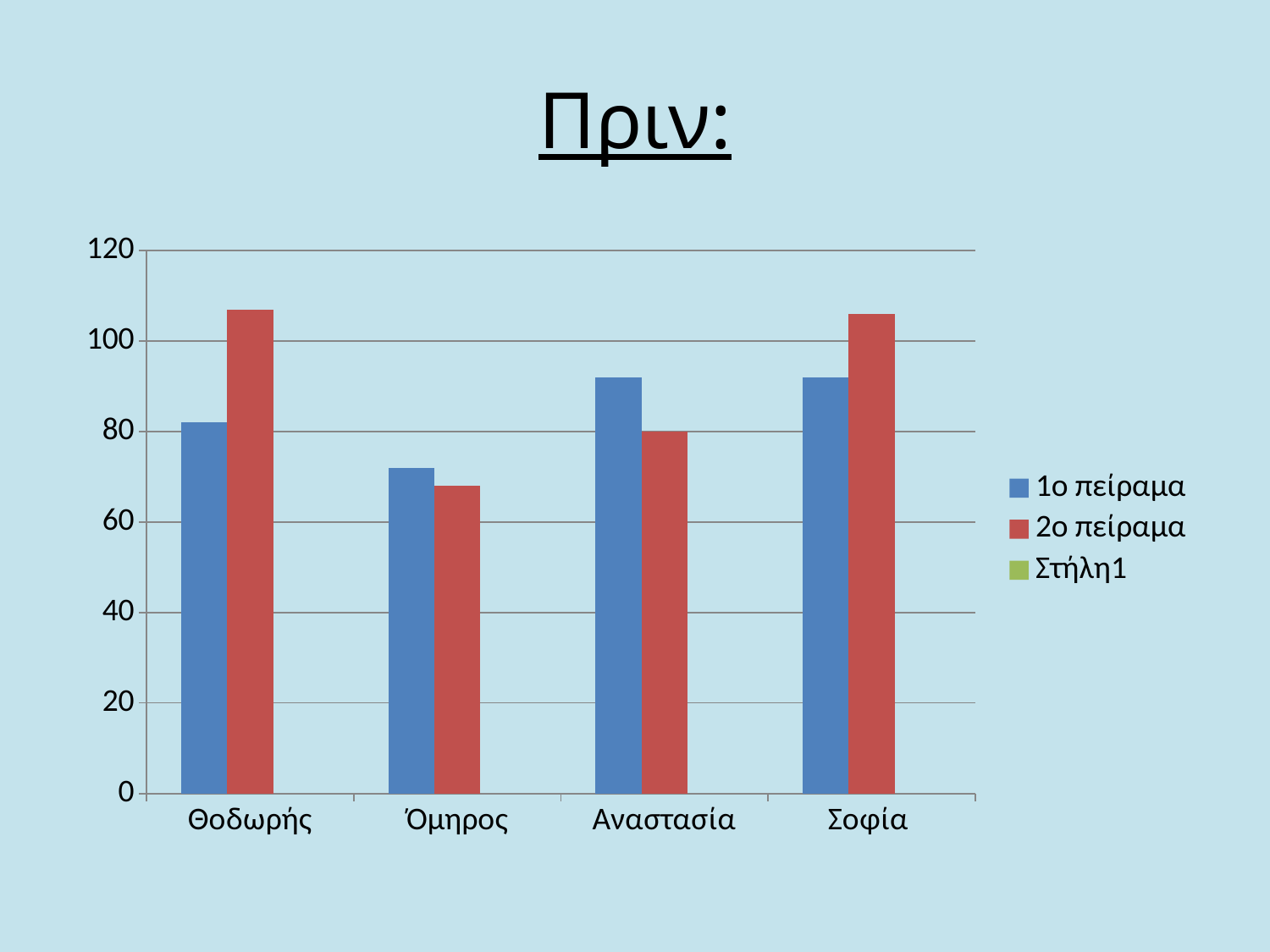
For Θοδωρής, which is larger: the 1ο πείραμα value or the 2ο πείραμα value? 2ο πείραμα How many categories (names) are shown on the x axis of the chart? 4 Is the 1ο πείραμα value for Αναστασία greater or less than 80? greater For Σοφία, which is larger: the 1ο πείραμα value or the 2ο πείραμα value? 2ο πείραμα Which category has the lowest value for the 1ο πείραμα series? Όμηρος What kind of chart is shown on the slide? bar chart For Αναστασία, which is larger: the 1ο πείραμα value or the 2ο πείραμα value? 1ο πείραμα Which category has the lowest value for the 2ο πείραμα series? Όμηρος Is the 2ο πείραμα value for Θοδωρής greater or less than 100? greater Is the 1ο πείραμα value for Όμηρος greater or less than 80? less What is the title of the slide above the chart? Πριν: How many series does the chart's legend list? 3